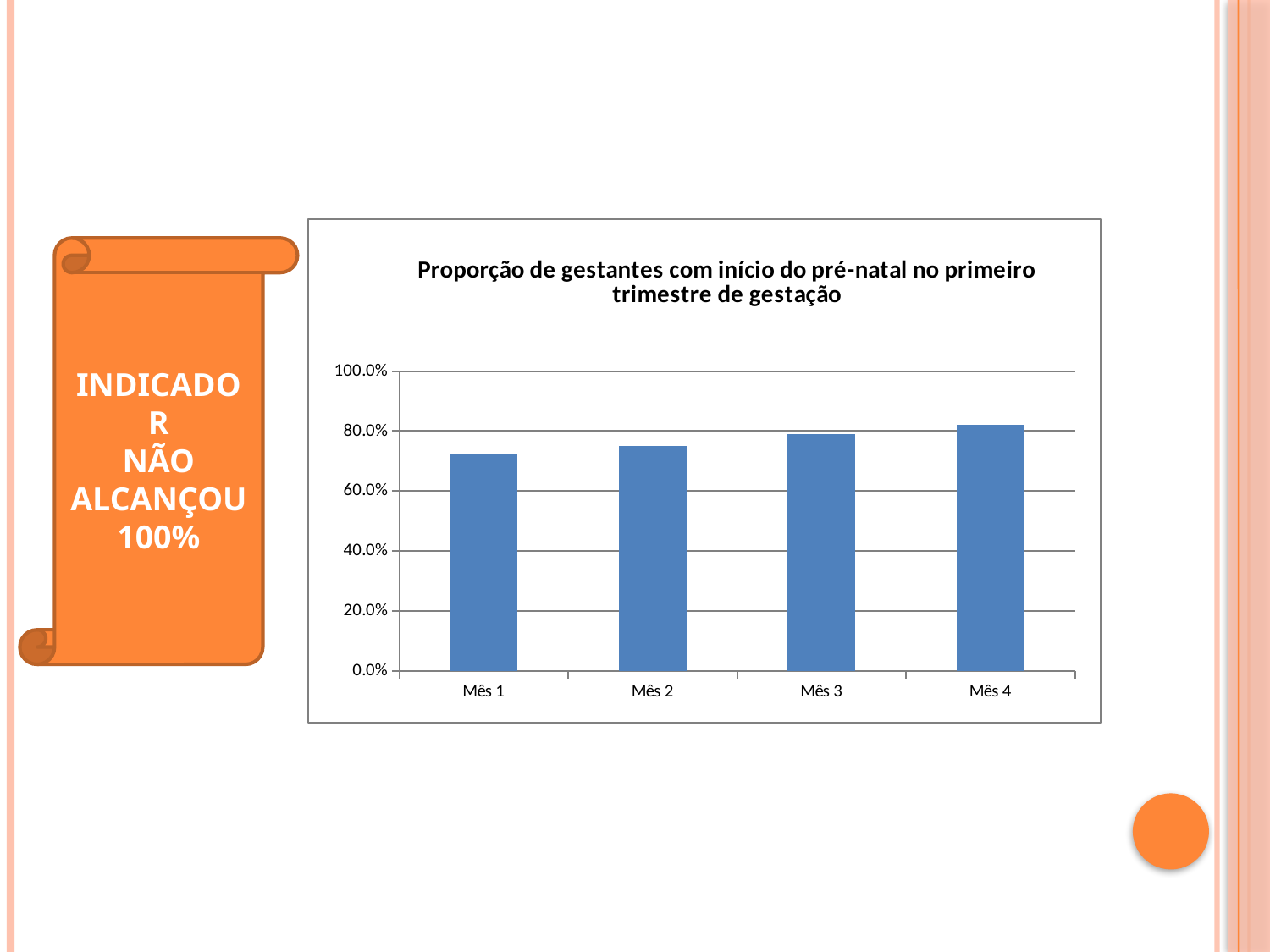
What kind of chart is shown on the slide? bar chart Which is larger, the value for Mês 2 or the value for Mês 4? Mês 4 Which month has the lowest bar? Mês 1 Is the value for Mês 2 greater or less than 80.0%? less Do the values rise or fall from Mês 1 to Mês 4? rise What is the title of the chart? Proporção de gestantes com início do pré-natal no primeiro trimestre de gestação Is the value for Mês 4 greater or less than 100.0%? less What colour are the bars in the chart? blue Is the value for Mês 1 greater or less than 60.0%? greater How many categories (months) are plotted on the x axis? 4 Which month has the highest bar? Mês 4 Which is larger, the value for Mês 1 or the value for Mês 4? Mês 4